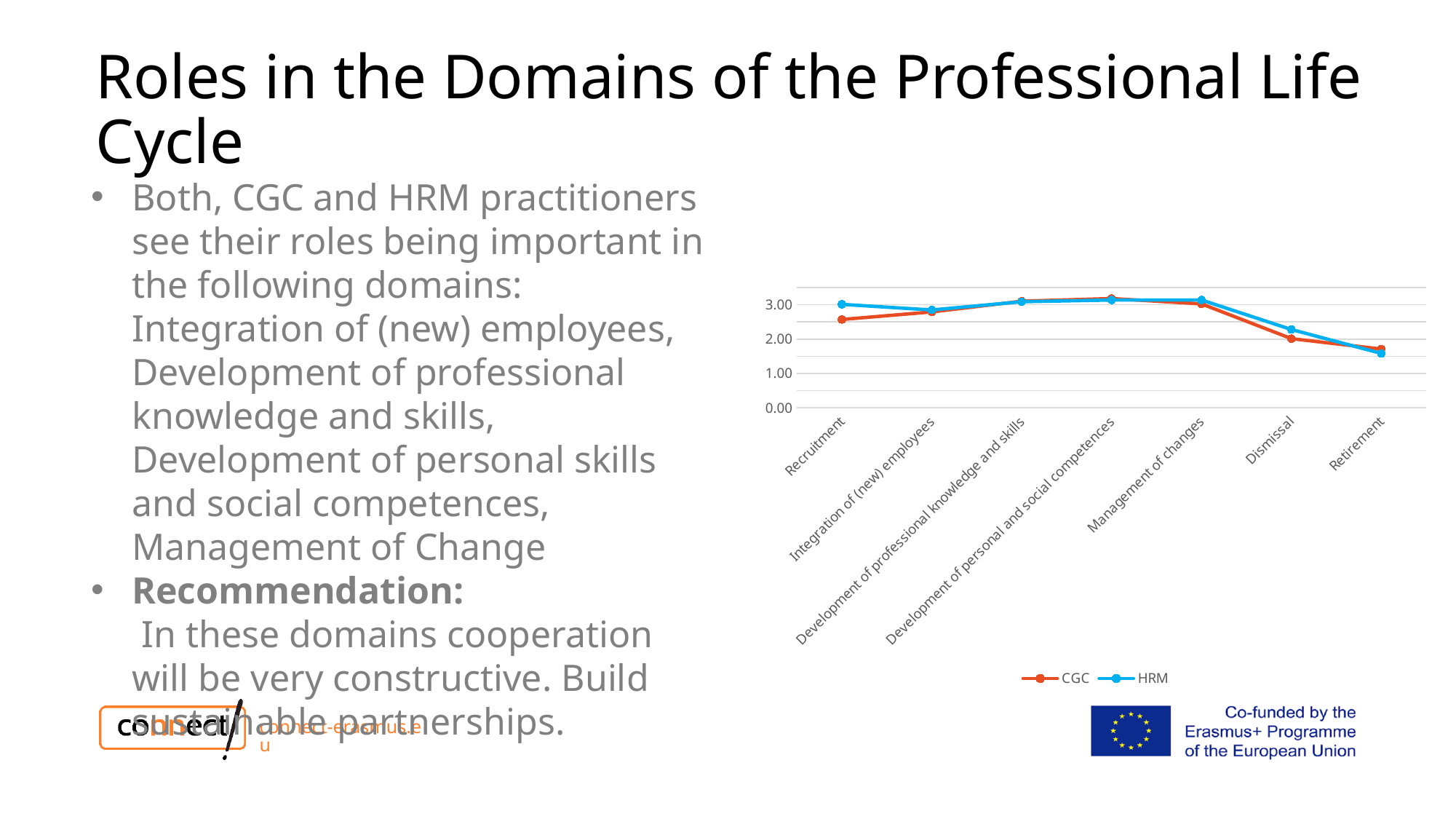
Which category has the lowest value for the CGC series? Retirement How many categories are shown along the x axis of the chart? 7 Which two series are listed in the chart legend? CGC and HRM Do the values for both series rise or fall from Management of changes to Retirement? fall What kind of chart is shown on the slide? line chart How many series does the chart legend list? 2 For Dismissal, which series has the larger value, CGC or HRM? HRM Is the HRM value for Retirement greater or less than 2.00? less Is the CGC value for Retirement greater or less than 2.00? less For Recruitment, which series has the larger value, CGC or HRM? HRM Is the HRM value for Dismissal greater or less than 2.00? greater